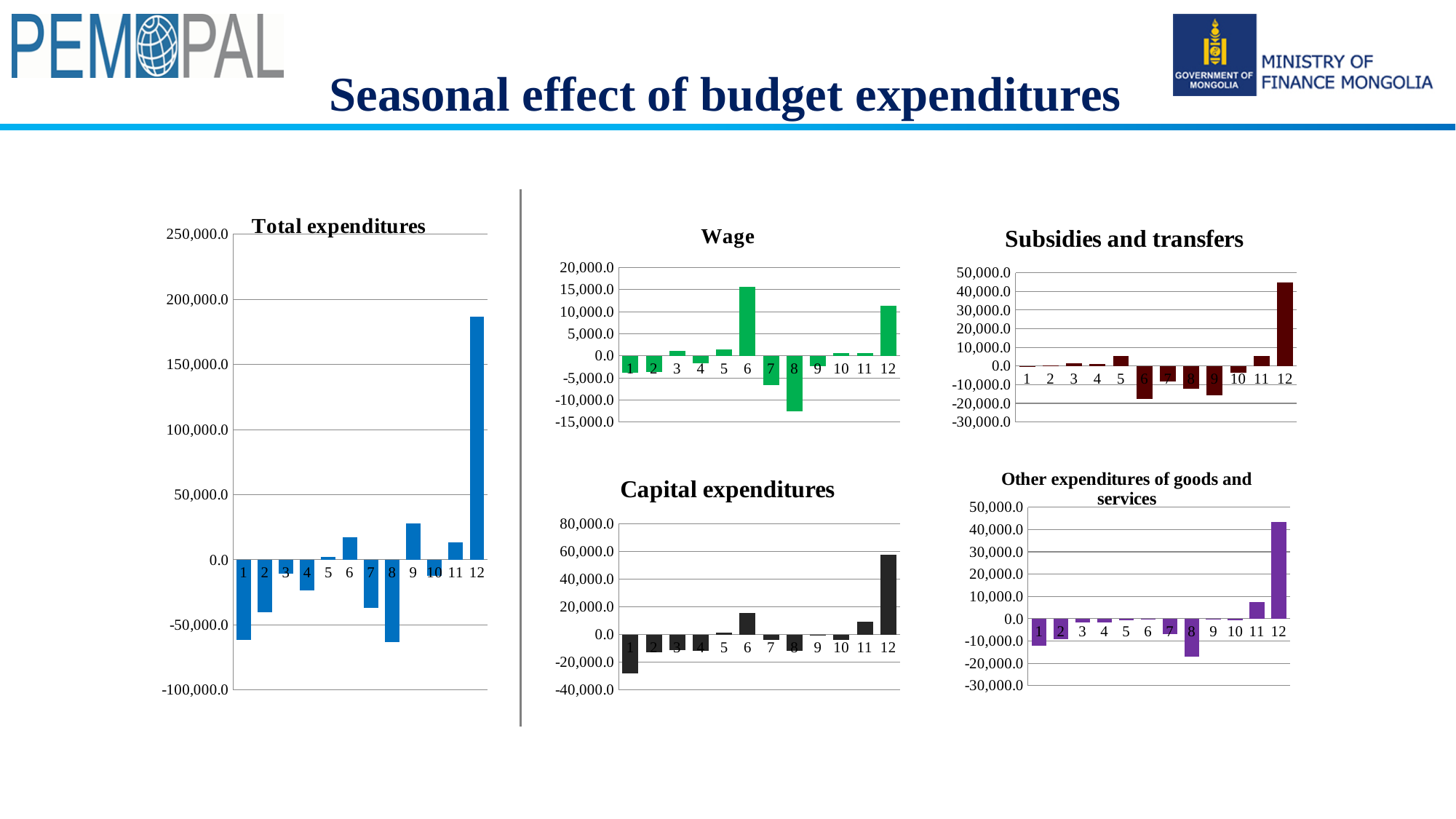
In the Capital expenditures chart, which month has the lowest value? 1 In the Total expenditures chart, is the value for month 12 greater or less than 150,000.0? greater In the Total expenditures chart, which month has the highest value? 12 How many charts are shown on the slide? 5 In the Wage chart, which month has the lowest value? 8 In the Other expenditures of goods and services chart, which month has the lowest value? 8 What kind of chart is the Total expenditures chart? bar chart How many months are plotted in the Wage chart? 12 In the Capital expenditures chart, is the value for month 12 greater or less than 40,000.0? greater In the Subsidies and transfers chart, which month has the highest value? 12 In the Wage chart, is the value for month 6 greater or less than 10,000.0? greater In the Wage chart, which month has the highest value? 6